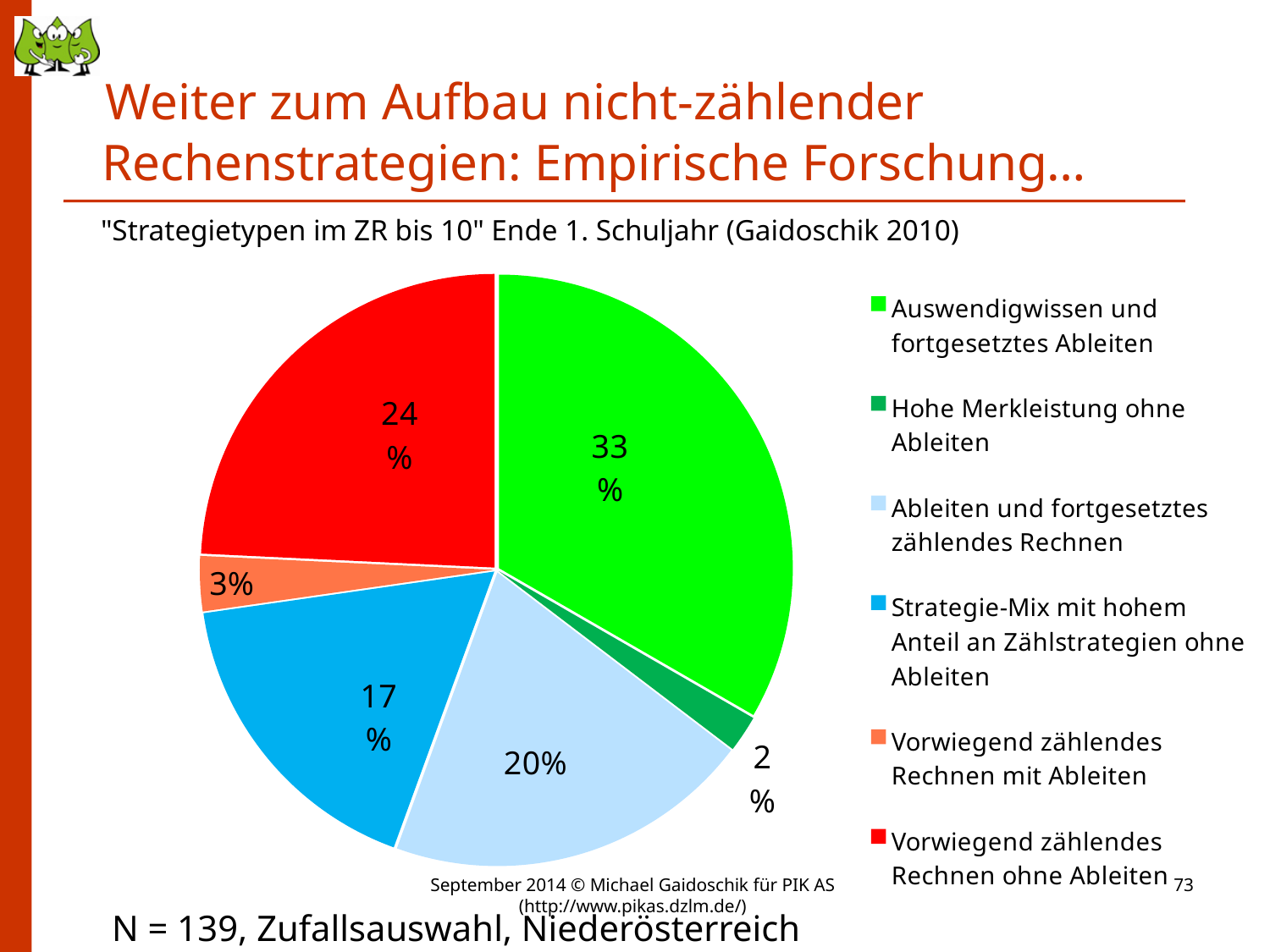
What percentage is shown for "Vorwiegend zählendes Rechnen ohne Ableiten"? 24% What percentage is shown for "Strategie-Mix mit hohem Anteil an Zählstrategien ohne Ableiten"? 17% Which category has the smallest slice of the pie? Hohe Merkleistung ohne Ableiten What percentage is shown for "Hohe Merkleistung ohne Ableiten"? 2% What is the difference in percentage points between "Auswendigwissen und fortgesetztes Ableiten" and "Vorwiegend zählendes Rechnen ohne Ableiten"? 9 What share of the pie is labelled for "Auswendigwissen und fortgesetztes Ableiten"? 33% Which is larger: the slice for "Ableiten und fortgesetztes zählendes Rechnen" or the slice for "Strategie-Mix mit hohem Anteil an Zählstrategien ohne Ableiten"? Ableiten und fortgesetztes zählendes Rechnen What kind of chart is shown on the slide? pie chart What percentage is shown for "Ableiten und fortgesetztes zählendes Rechnen"? 20% How many categories does the legend of the pie chart list? 6 Which category has the largest slice of the pie? Auswendigwissen und fortgesetztes Ableiten What colour is the slice for "Vorwiegend zählendes Rechnen mit Ableiten"? orange